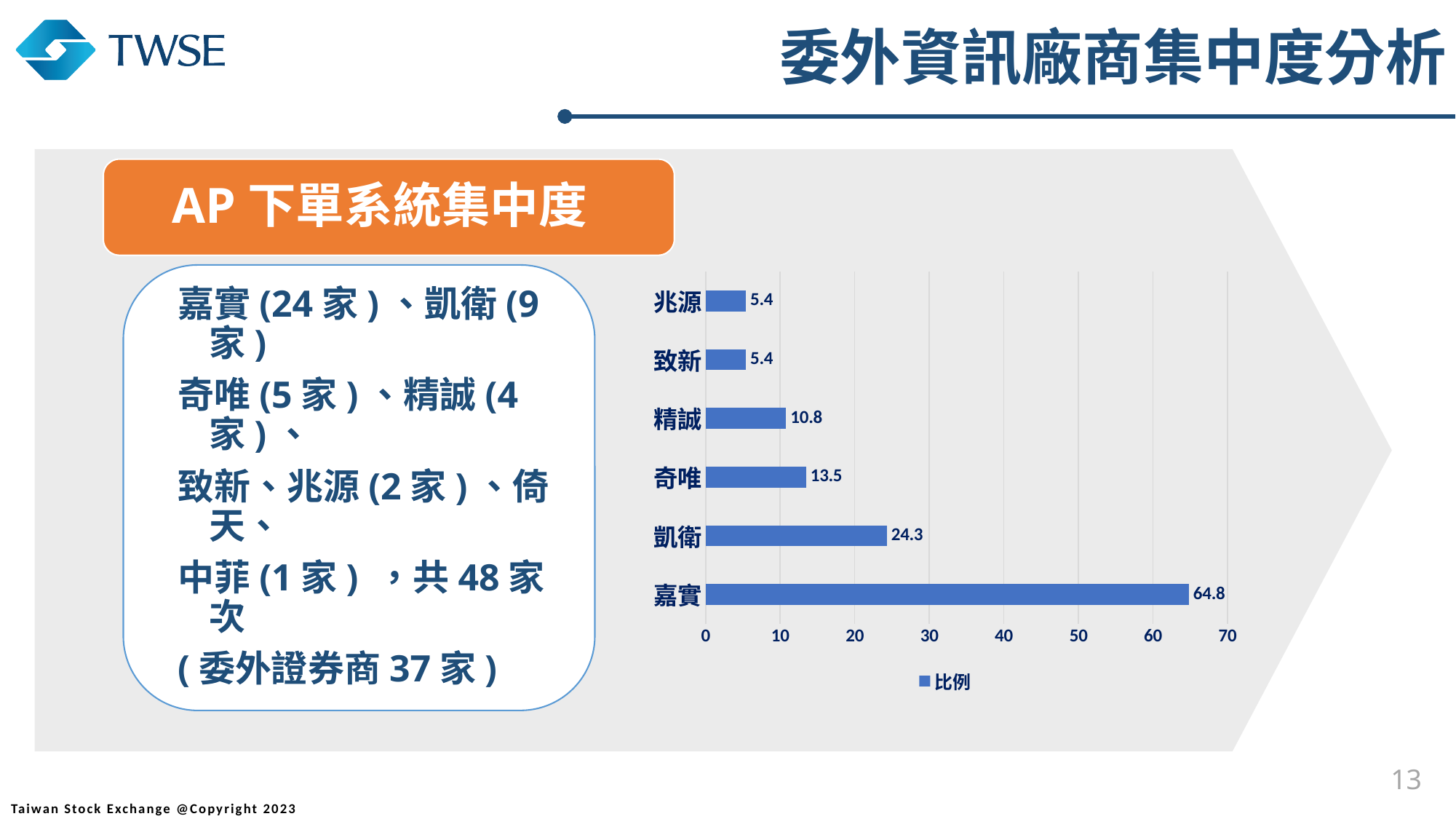
Which is larger, the value for 凱衛 or the value for 奇唯? 凱衛 What is the value for 凱衛 in the bar chart? 24.3 How many categories are shown in the bar chart? 6 What is the value for 奇唯 in the bar chart? 13.5 What is the value for 精誠 in the bar chart? 10.8 What is the difference between the values for 嘉實 and 凱衛? 40.5 What series name does the chart legend show? 比例 Is the value for 嘉實 greater or less than 60? greater What is the difference between the values for 奇唯 and 精誠? 2.7 What is the value for 嘉實 in the bar chart? 64.8 What kind of chart is shown on the slide? bar chart Which category has the highest value in the bar chart? 嘉實